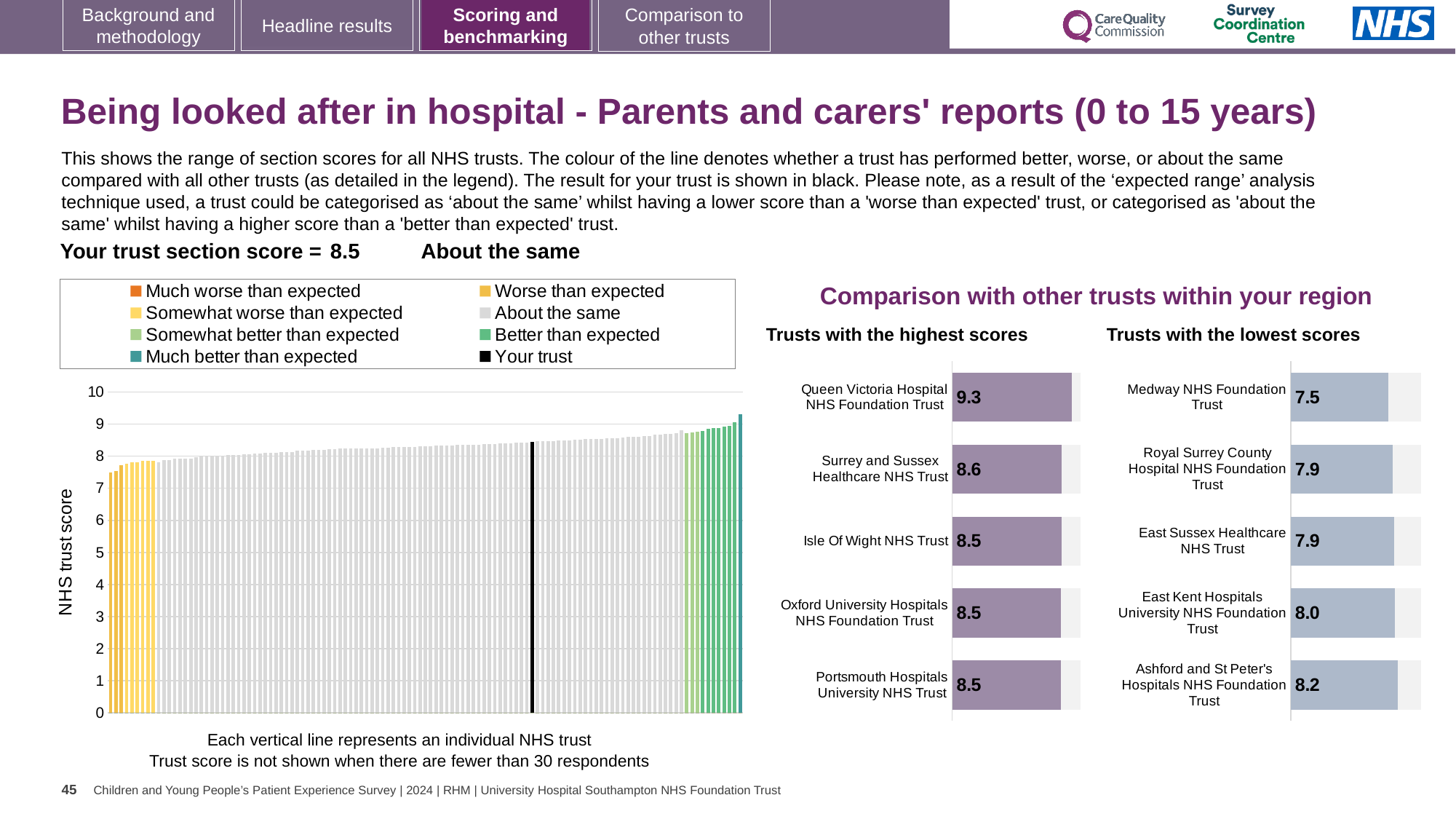
In the main chart of all NHS trusts on the left, what is the section score for your trust (the black line)? 8.5 In the 'Trusts with the lowest scores' chart, which trust has the lowest score? Medway NHS Foundation Trust In the 'Trusts with the lowest scores' chart, what is the score for Medway NHS Foundation Trust? 7.5 How many trusts are shown in the 'Trusts with the highest scores' chart? 5 In the 'Trusts with the lowest scores' chart, which has the higher score: East Kent Hospitals University NHS Foundation Trust or Royal Surrey County Hospital NHS Foundation Trust? East Kent Hospitals University NHS Foundation Trust In the 'Trusts with the highest scores' chart, which trust has the highest score? Queen Victoria Hospital NHS Foundation Trust In the 'Trusts with the highest scores' chart, what is the score for Queen Victoria Hospital NHS Foundation Trust? 9.3 What kind of chart is the 'Trusts with the lowest scores' chart? Bar chart In the 'Trusts with the highest scores' chart, what is the difference between the scores of Queen Victoria Hospital NHS Foundation Trust and Surrey and Sussex Healthcare NHS Trust? 0.7 In the 'Trusts with the lowest scores' chart, what is the difference between the scores of Ashford and St Peter's Hospitals NHS Foundation Trust and Medway NHS Foundation Trust? 0.7 How many entries does the legend of the main chart on the left list? 8 In the main chart on the left, is the value of the lowest-scoring trust (the leftmost bar) greater or less than 8? less